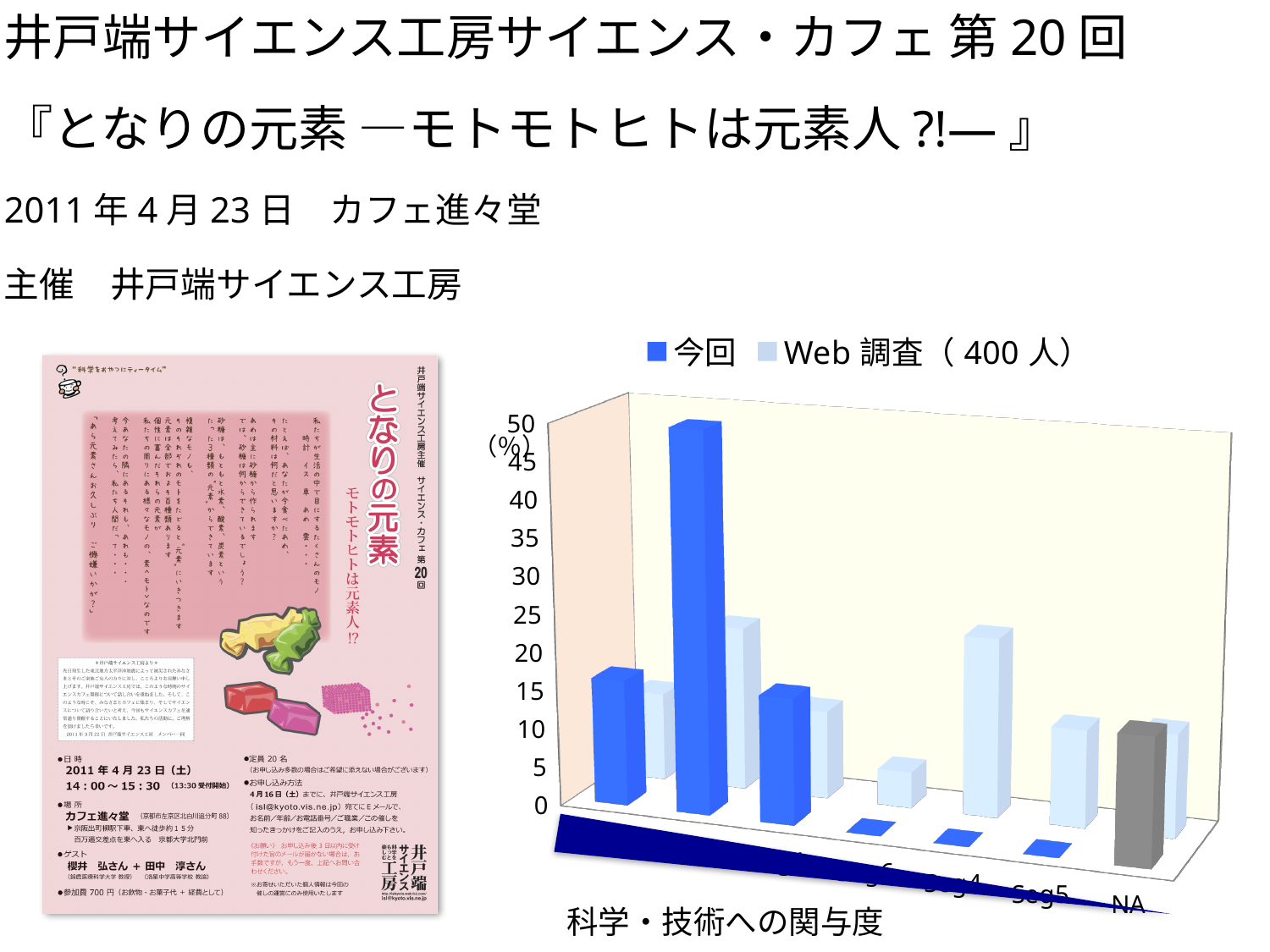
How many category groups of bars are plotted along the x axis? 7 How many series does the chart legend list? 2 At Seg4, which series has the larger value, 今回 or Web 調査? Web 調査 Is the value for Web 調査 at Seg4 greater or less than 10? greater What are the two series named in the chart legend? 今回 and Web 調査（400 人） What is the highest tick value shown on the chart's vertical axis? 50 What kind of chart is shown on the slide? bar chart Which series contains the tallest bar in the chart? 今回 Is the value for 今回 at Seg4 greater or less than 5? less Is the value for 今回 at Seg5 greater or less than 5? less What is the title of the chart's x axis? 科学・技術への関与度 At Seg5, which series has the larger value, 今回 or Web 調査? Web 調査